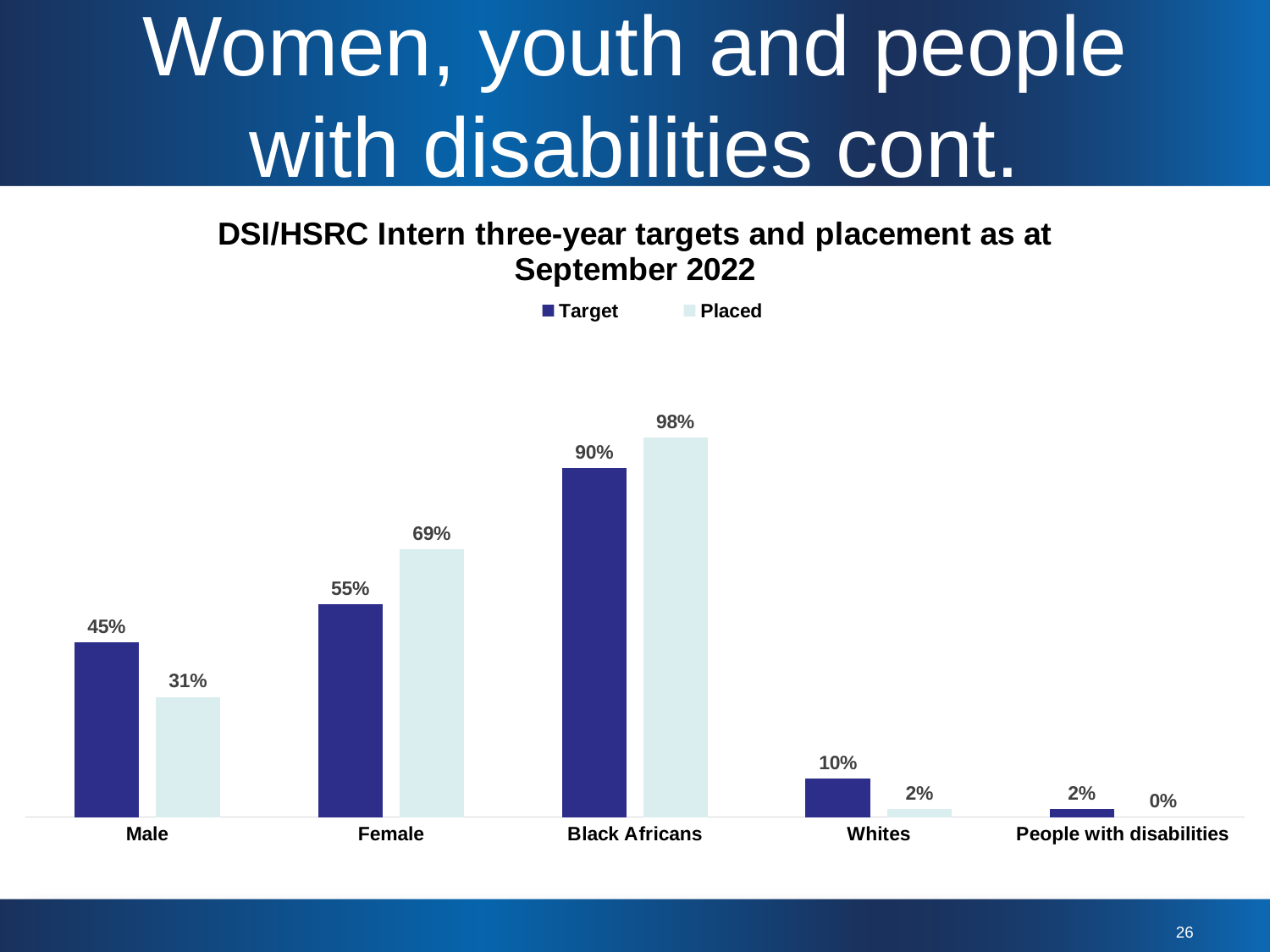
What kind of chart is shown on the slide? Bar chart Which is larger for Female, the Target value or the Placed value? Placed Which category has the lowest Placed value? People with disabilities What is the Placed value for Black Africans? 98% What is the title of the chart? DSI/HSRC Intern three-year targets and placement as at September 2022 How many series does the legend list? 2 What is the Target value for Female? 55% What is the Placed value for Whites? 2% How many categories are shown on the x axis? 5 Which category has the highest Target value? Black Africans What is the difference between the Target and Placed values for Male? 14% What is the difference between the Placed values for Black Africans and Female? 29%